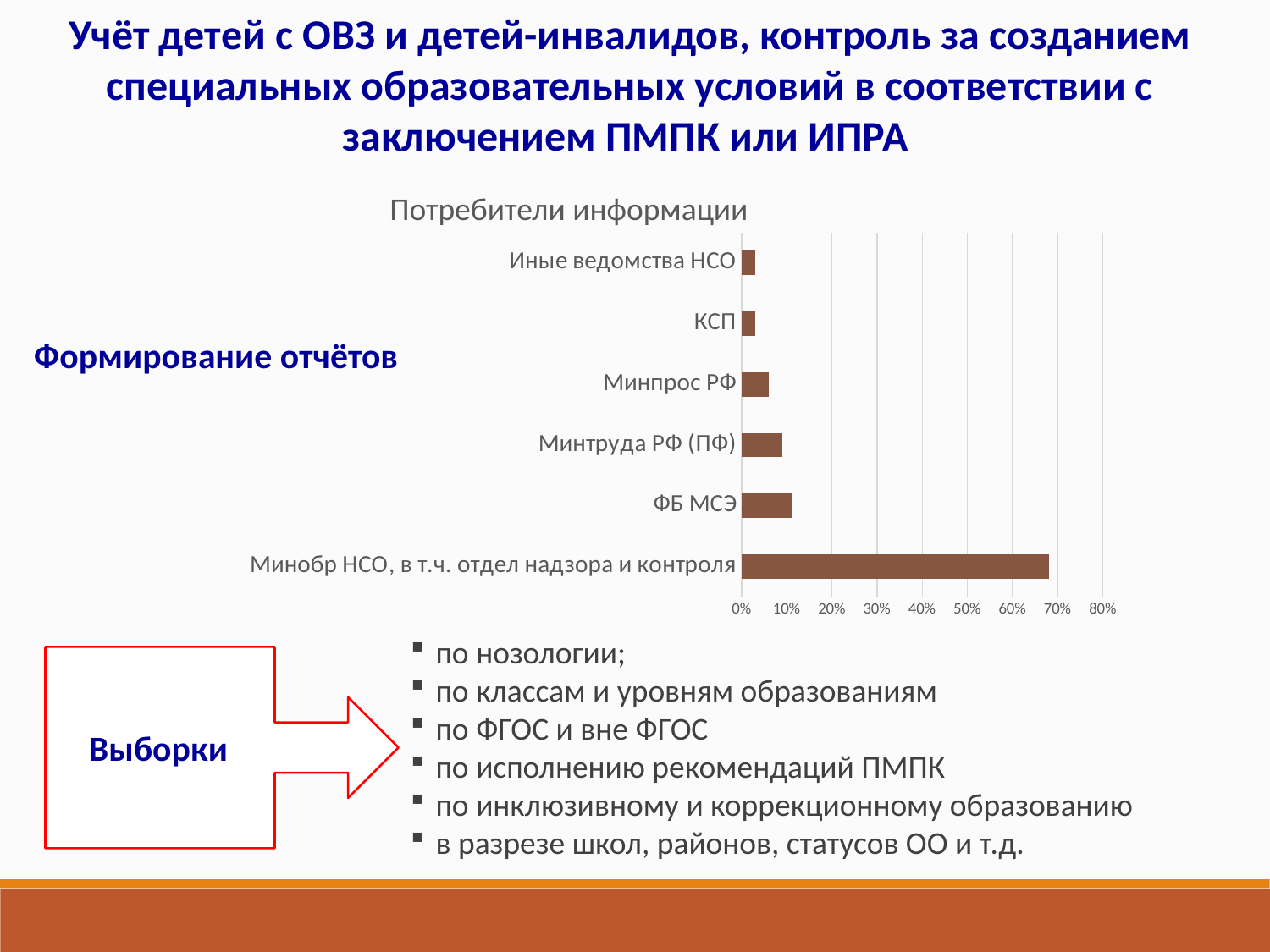
Is the value for "Минпрос РФ" greater or less than 10%? less Is the value for "ФБ МСЭ" greater or less than 20%? less Which has a larger value, "ФБ МСЭ" or "Минпрос РФ"? ФБ МСЭ Which has a larger value, "Минобр НСО, в т.ч. отдел надзора и контроля" or "ФБ МСЭ"? Минобр НСО, в т.ч. отдел надзора и контроля Is the value for "Минобр НСО, в т.ч. отдел надзора и контроля" greater or less than 60%? greater Which has a larger value, "Минтруда РФ (ПФ)" or "Минпрос РФ"? Минтруда РФ (ПФ) How many categories are plotted in the "Потребители информации" chart? 6 Which category has the highest value in the "Потребители информации" chart? Минобр НСО, в т.ч. отдел надзора и контроля What is the highest value shown on the horizontal axis of the chart? 80% What kind of chart is shown under the heading "Потребители информации"? bar chart What is the title of the chart on the slide? Потребители информации